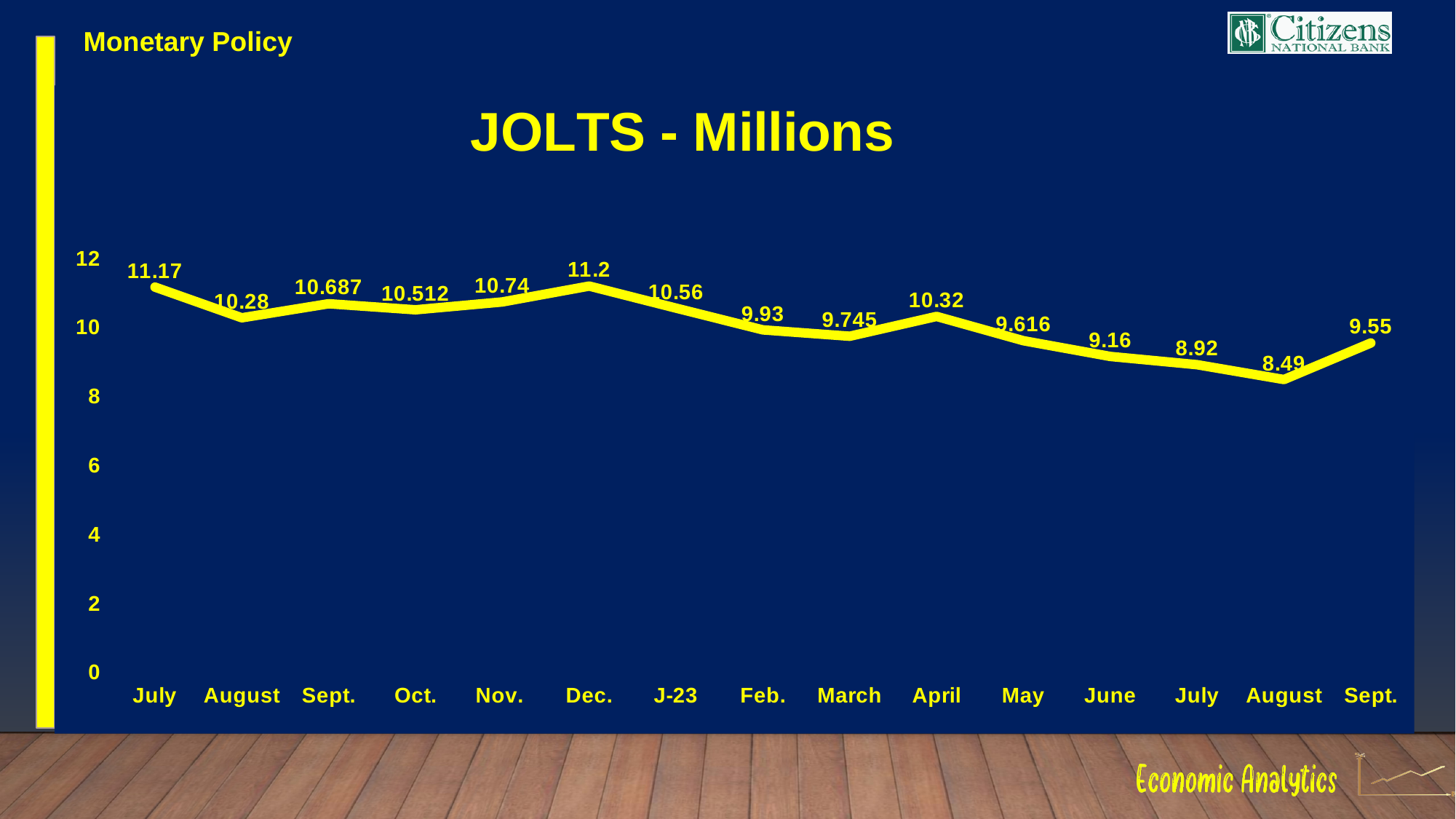
Which month has the highest JOLTS value? Dec. What is the JOLTS value for Dec.? 11.2 What is the title of the chart? JOLTS - Millions What is the difference between the Dec. value and the final Sept. value? 1.65 Which is larger, the value for March or the value for April? April What is the JOLTS value for J-23? 10.56 What is the JOLTS value for April? 10.32 How many data points are plotted on the line? 15 Do the JOLTS values generally rise or fall from the first July to the second August? fall Which month has the lowest JOLTS value? August (the second August, 8.49) What is the difference between the first July value and the second July value? 2.25 What kind of chart is shown on the slide? line chart